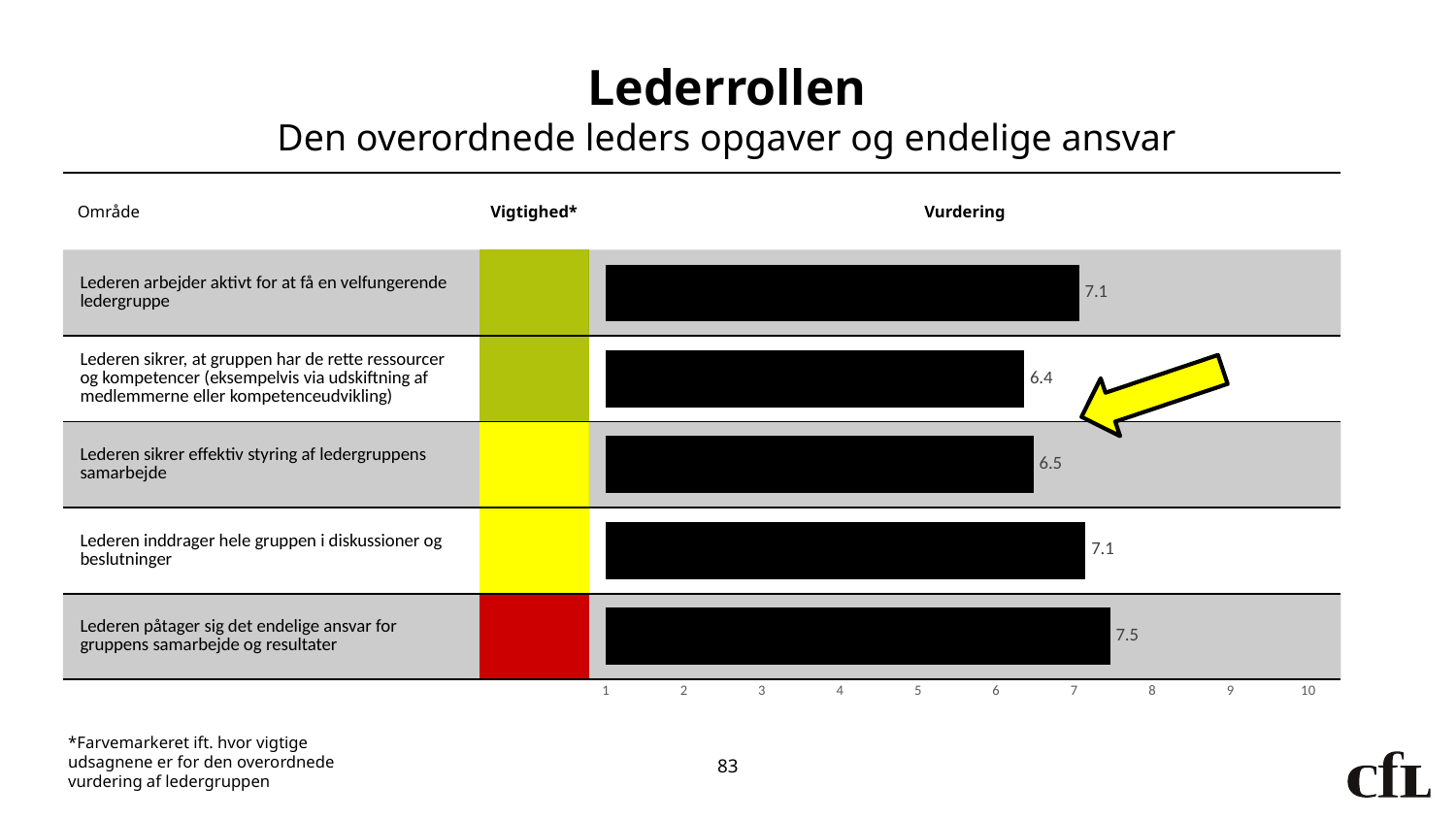
Which has a higher Vurdering: "Lederen påtager sig det endelige ansvar" or "Lederen inddrager hele gruppen i diskussioner og beslutninger"? Lederen påtager sig det endelige ansvar Is the Vurdering value for "Lederen sikrer effektiv styring af ledergruppens samarbejde" greater or less than 7? less Which area has the highest Vurdering value? Lederen påtager sig det endelige ansvar for gruppens samarbejde og resultater What is the Vurdering value for "Lederen påtager sig det endelige ansvar for gruppens samarbejde og resultater"? 7.5 What is the difference between the highest and lowest Vurdering values? 1.1 What is the difference between the Vurdering for "Lederen inddrager hele gruppen i diskussioner og beslutninger" and "Lederen sikrer effektiv styring af ledergruppens samarbejde"? 0.6 Which area has the lowest Vurdering value? Lederen sikrer, at gruppen har de rette ressourcer og kompetencer What kind of chart is shown on the slide? bar chart What is the Vurdering value for "Lederen sikrer, at gruppen har de rette ressourcer og kompetencer"? 6.4 How many areas are plotted in the chart? 5 What is the Vurdering value for "Lederen arbejder aktivt for at få en velfungerende ledergruppe"? 7.1 What colour is the Vigtighed marker for "Lederen påtager sig det endelige ansvar for gruppens samarbejde og resultater"? red